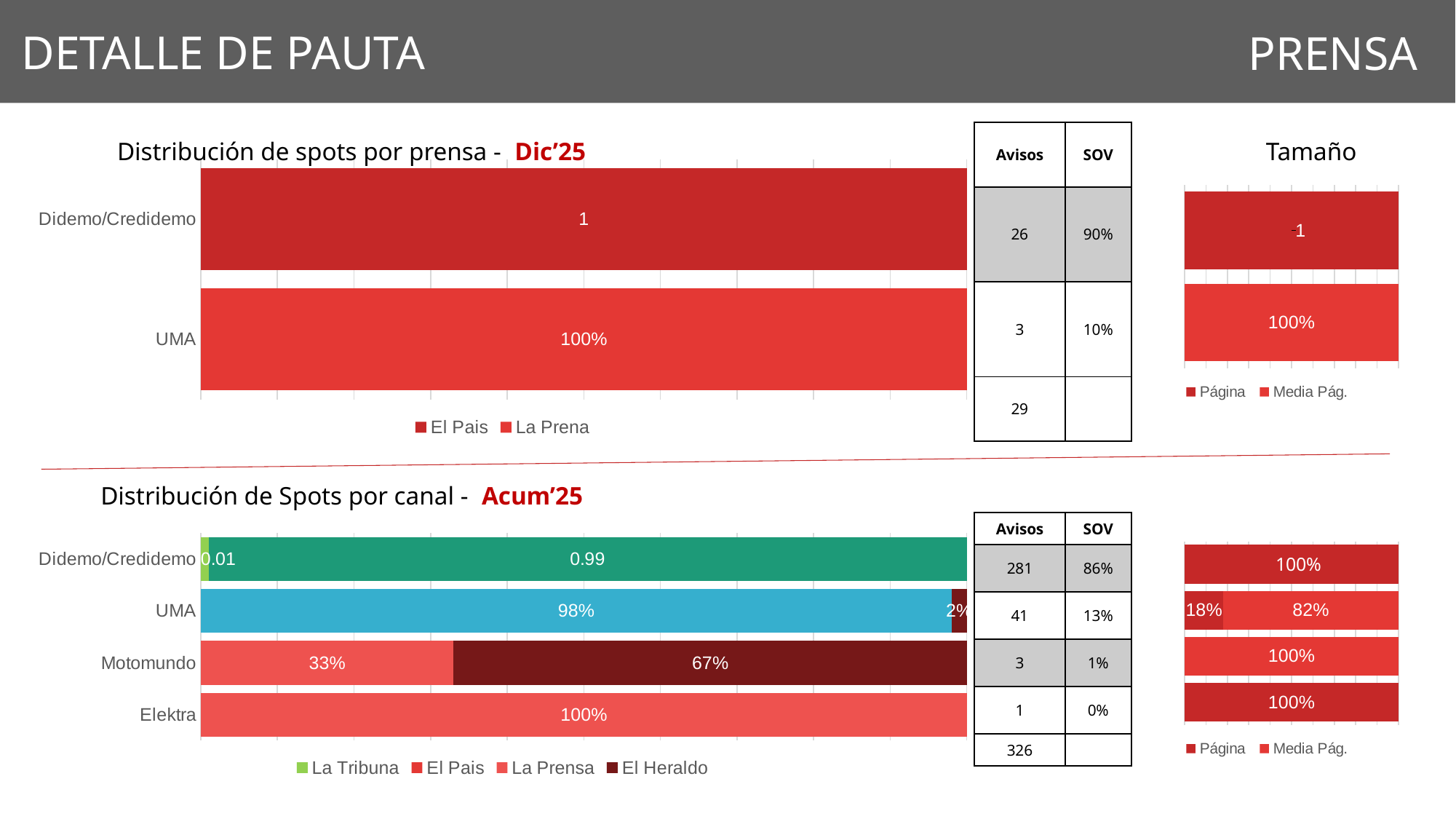
In the 'Distribución de spots por prensa - Dic'25' chart, what is the data label on the UMA bar? 100% In the 'Distribución de Spots por canal - Acum'25' chart, what is the larger data label on the UMA bar? 98% How many series does the legend of the 'Distribución de Spots por canal - Acum'25' chart list? 4 In the 'Distribución de Spots por canal - Acum'25' chart, what are the two data labels on the Motomundo bar? 33% and 67% In the lower 'Tamaño' chart on the right, what are the two data labels on the UMA bar? 18% and 82% How many series does the legend of the 'Distribución de spots por prensa - Dic'25' chart list? 2 In the 'Distribución de spots por prensa - Dic'25' chart, what is the data label on the Didemo/Credidemo bar? 1 How many categories are shown in the 'Distribución de Spots por canal - Acum'25' chart? 4 In the 'Distribución de Spots por canal - Acum'25' chart, which segment of the Motomundo bar is larger, 33% or 67%? 67% How many categories are shown in the 'Distribución de spots por prensa - Dic'25' chart? 2 In the 'Distribución de Spots por canal - Acum'25' chart, what is the data label on the Elektra bar? 100% What kind of chart is 'Distribución de Spots por canal - Acum'25'? Bar chart